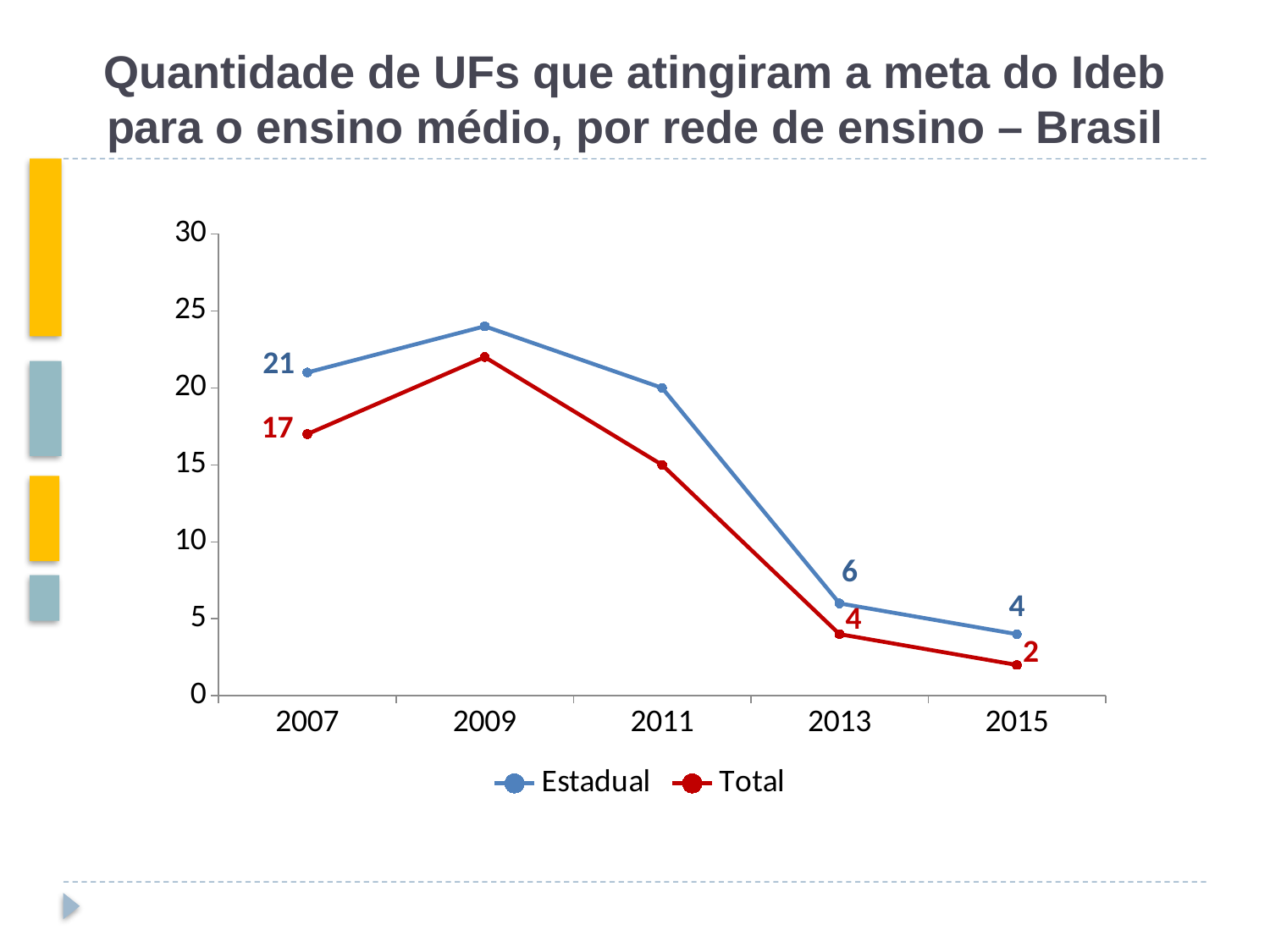
What type of chart is shown on the slide? Line chart How many series does the legend list? 2 What is the difference between Estadual and Total in 2007? 4 What is the difference between Estadual and Total in 2015? 2 Is the value for Estadual in 2009 greater or less than 20? greater Is the value for Total in 2011 greater or less than 20? less In which year does the Estadual series reach its highest value? 2009 What is the value for Estadual in 2013? 6 What is the value for Estadual in 2007? 21 What is the value for Total in 2007? 17 What is the value for Total in 2015? 2 How many years are shown on the x axis? 5